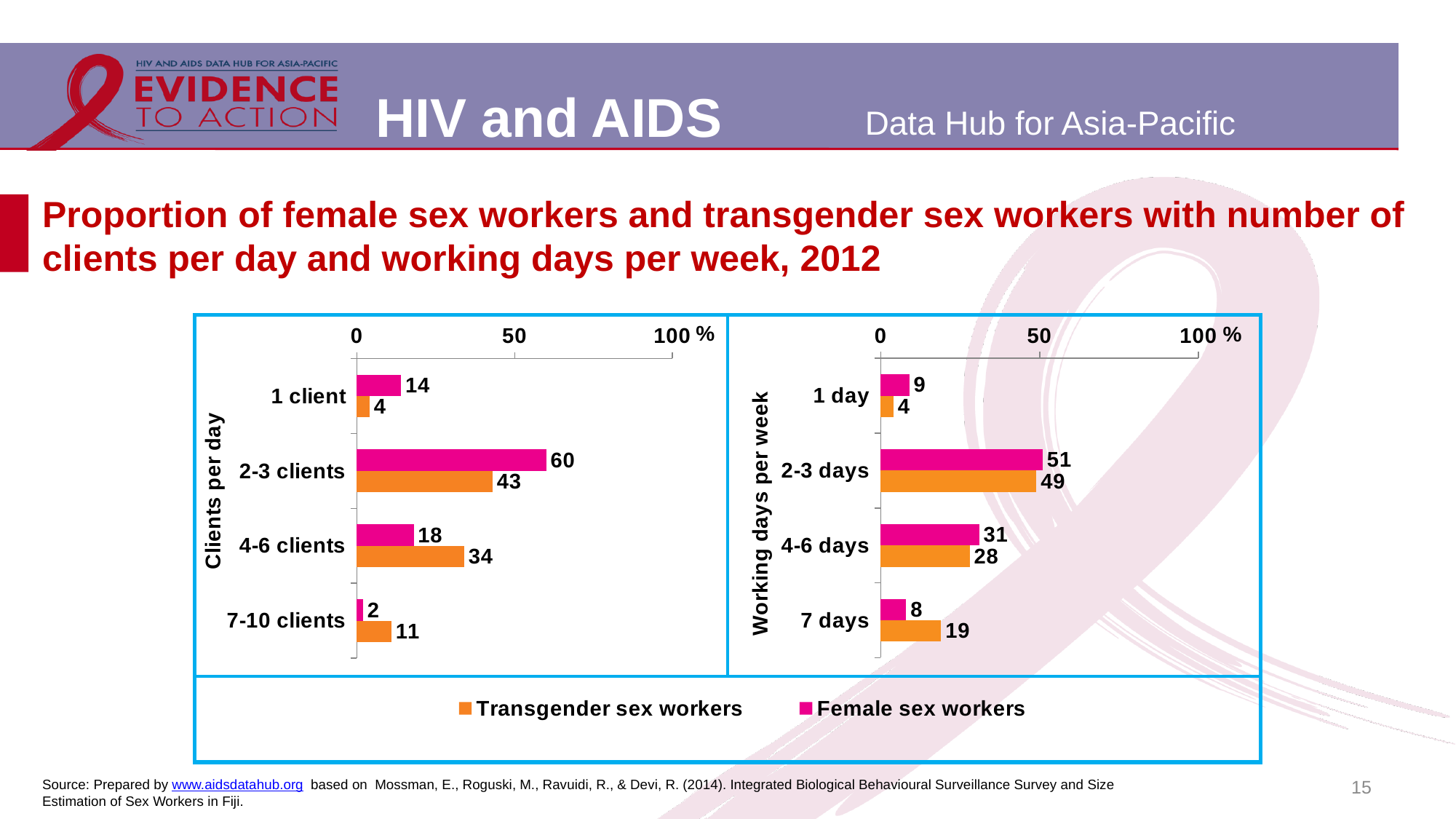
In the left chart (Clients per day), which category has the highest value for transgender sex workers? 2-3 clients In the left chart (Clients per day), what is the value for female sex workers with 2-3 clients? 60 In the left chart (Clients per day), which is larger for 4-6 clients: female sex workers or transgender sex workers? Transgender sex workers What kind of chart is the left chart (Clients per day)? Bar chart In the left chart (Clients per day), what is the value for transgender sex workers with 4-6 clients? 34 How many categories are shown in the right chart (Working days per week)? 4 How many series does the legend list? 2 In the right chart (Working days per week), what is the value for female sex workers working 1 day? 9 In the left chart (Clients per day), which category has the lowest value for female sex workers? 7-10 clients In the right chart (Working days per week), is the value for female sex workers working 2-3 days greater or less than 50? greater In the right chart (Working days per week), what is the difference between female sex workers and transgender sex workers for 7 days? 11 In the right chart (Working days per week), what is the value for transgender sex workers working 7 days? 19